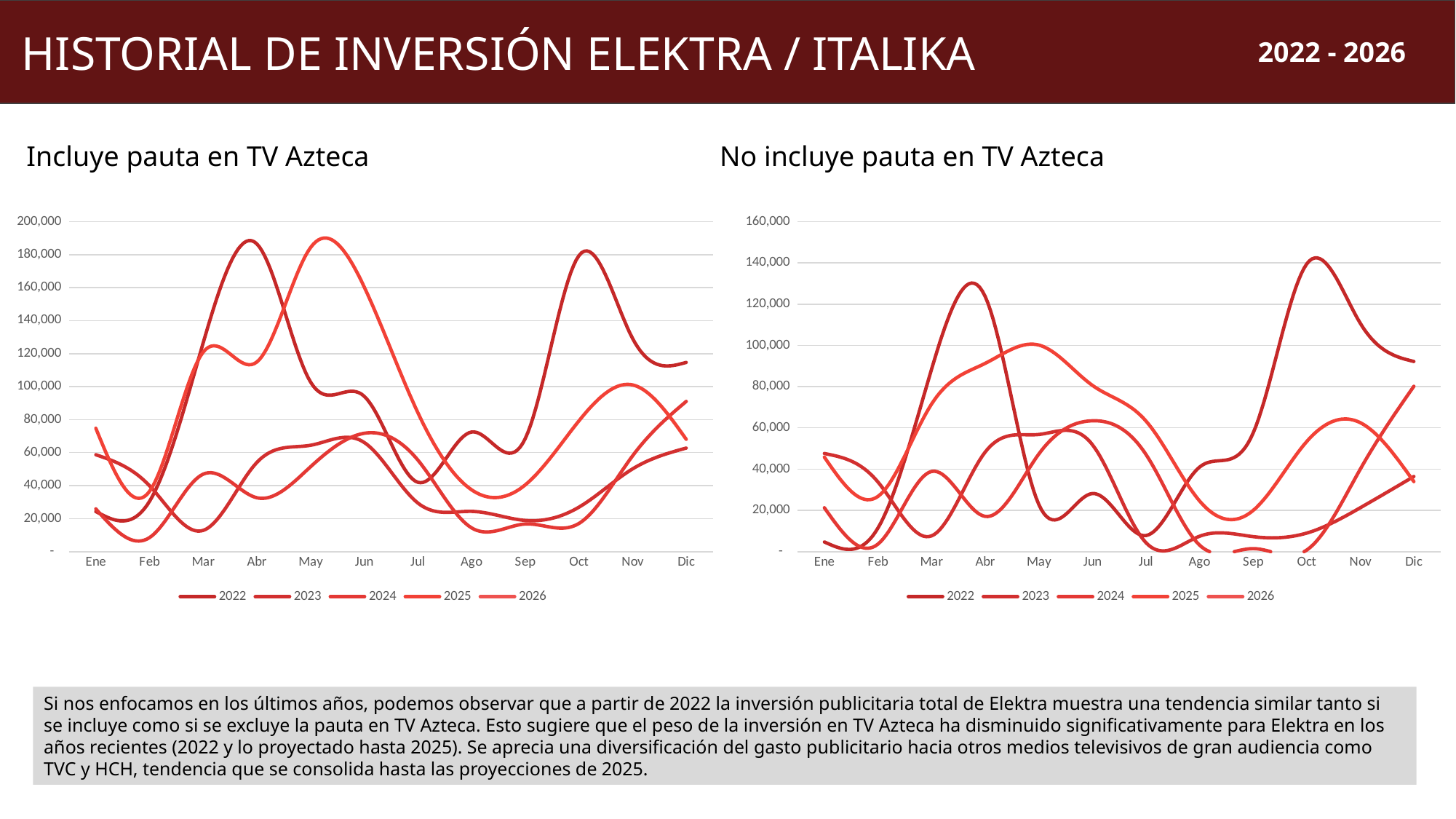
How many categories are on the x axis of the 'No incluye pauta en TV Azteca' chart? 12 What is the title of the chart on the left of the slide? Incluye pauta en TV Azteca In the 'No incluye pauta en TV Azteca' chart, is the highest point reached by any line greater or less than 160,000? less In the 'Incluye pauta en TV Azteca' chart, is the highest point reached by any line greater or less than 180,000? greater In the 'Incluye pauta en TV Azteca' chart, is the highest value at Ene greater or less than 100,000? less How many categories are on the x axis of the 'Incluye pauta en TV Azteca' chart? 12 What kind of chart is the 'No incluye pauta en TV Azteca' chart? line chart How many series does the legend of the 'Incluye pauta en TV Azteca' chart list? 5 What is the title of the chart on the right of the slide? No incluye pauta en TV Azteca How many series does the legend of the 'No incluye pauta en TV Azteca' chart list? 5 What kind of chart is the 'Incluye pauta en TV Azteca' chart? line chart